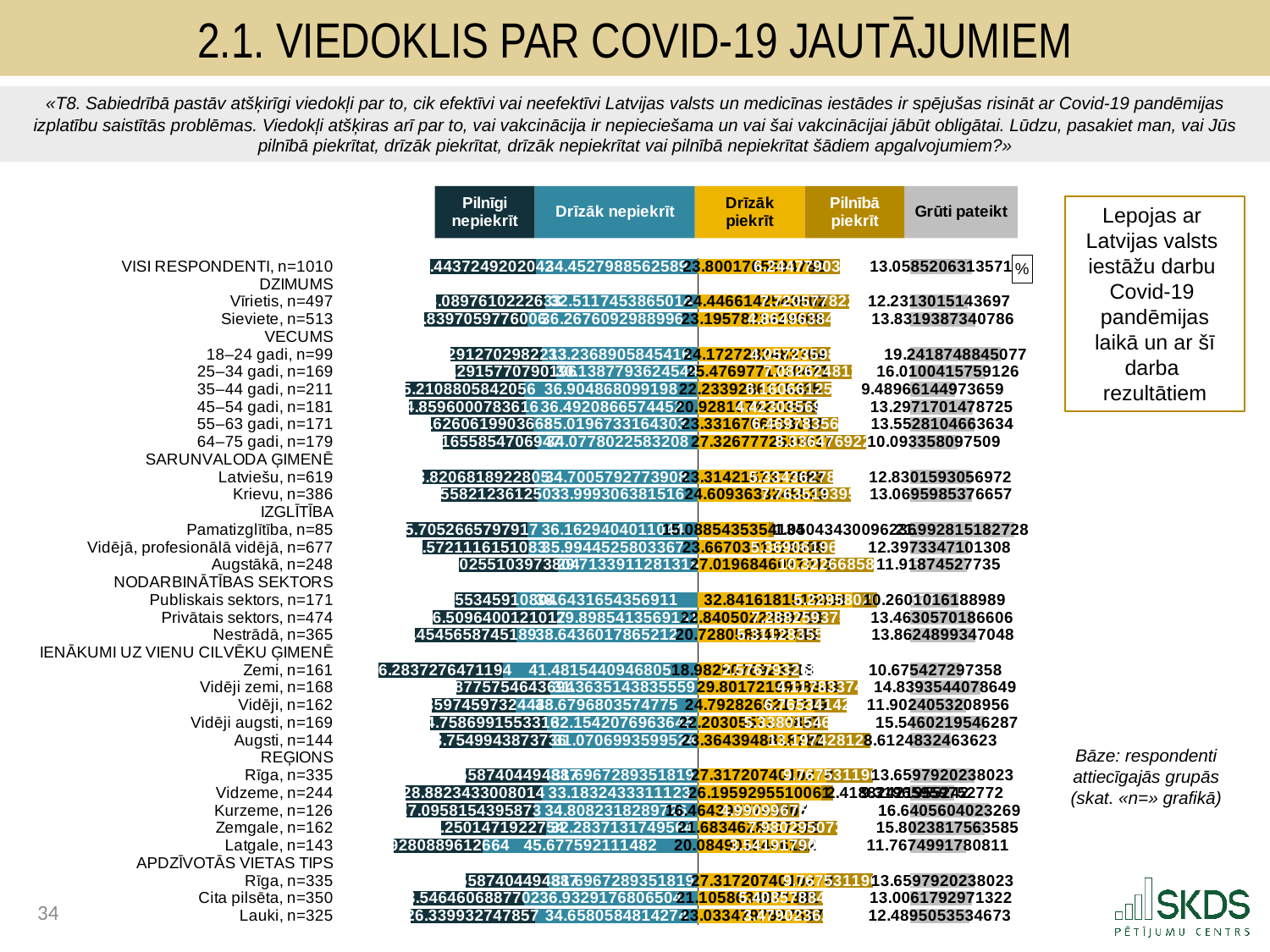
What is the 'Pilnīgi nepiekrīt' value for the group 'Zemi, n=161'? 26.2837276471194 What kind of chart is shown on the slide? Stacked horizontal bar chart Among the age groups (VECUMS), which group has the highest 'Grūti pateikt' value? 18–24 gadi, n=99 Among the age groups (VECUMS), which group has the lowest 'Grūti pateikt' value? 35–44 gadi, n=211 Which has a larger 'Grūti pateikt' value: '18–24 gadi, n=99' or '35–44 gadi, n=211'? 18–24 gadi, n=99 Which series is shown in grey in the chart legend? Grūti pateikt What statement is the chart about, according to the text box on the right of the chart? Lepojas ar Latvijas valsts iestāžu darbu Covid-19 pandēmijas laikā un ar šī darba rezultātiem What is the 'Grūti pateikt' value for the group '18–24 gadi, n=99'? 19.2418748845077 What is the 'Grūti pateikt' value for the group '35–44 gadi, n=211'? 9.48966144973659 How many series does the chart legend list? 5 What is the 'Grūti pateikt' value for the group 'Kurzeme, n=126'? 16.6405604023269 What is the 'Drīzāk nepiekrīt' value for the group 'Latgale, n=143'? 45.677592111482